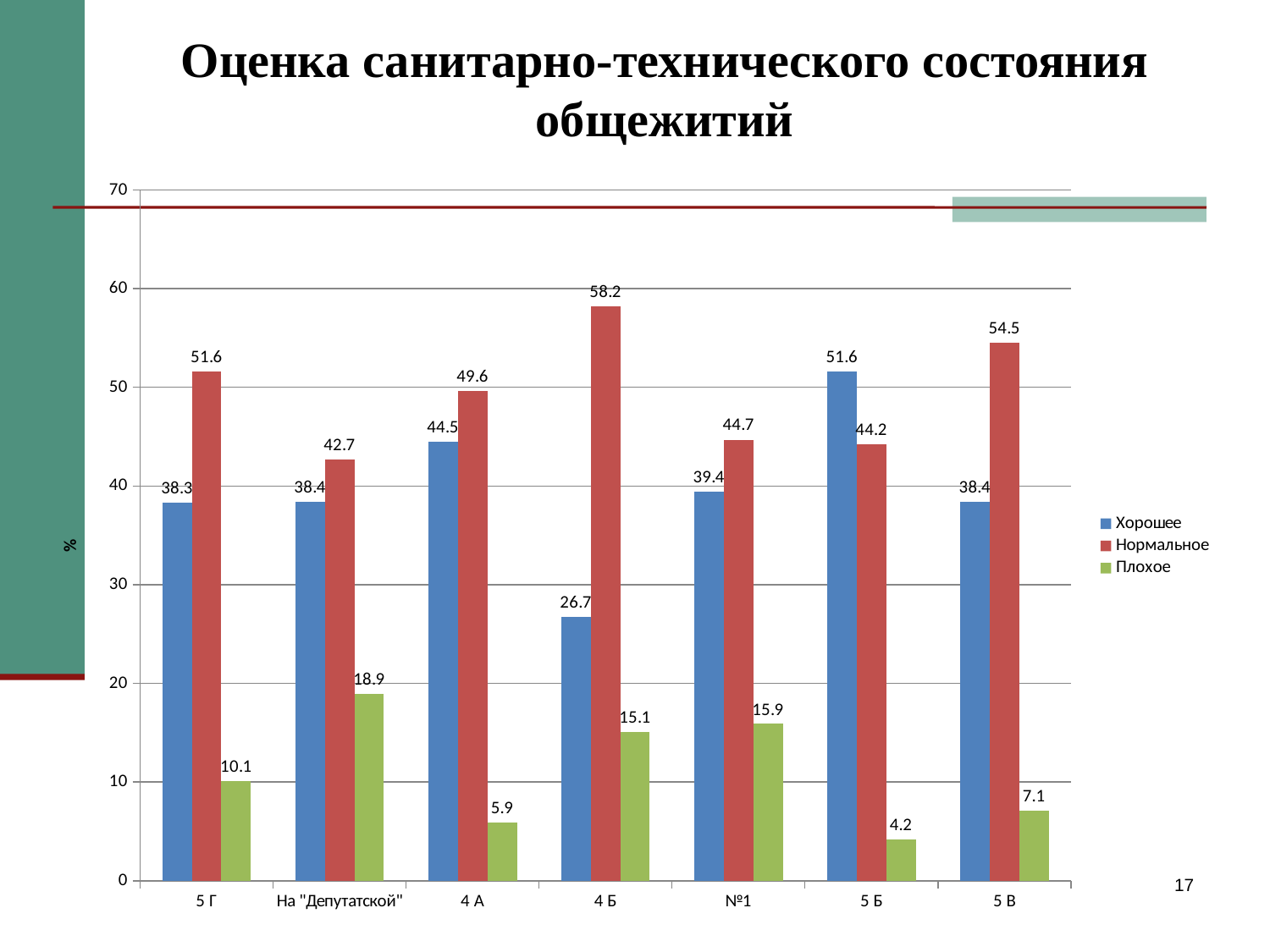
Which is larger for 5 Б: Хорошее or Нормальное? Хорошее Which category has the lowest Хорошее value? 4 Б What is the value of Плохое for На "Депутатской"? 18.9 What is the value of Нормальное for 4 Б? 58.2 What kind of chart is shown on the slide? Bar chart Which category has the lowest Плохое value? 5 Б How many categories are shown on the x axis? 7 How many series does the legend list? 3 What is the value of Хорошее for 5 Б? 51.6 What is the difference between the Нормальное and Хорошее values for 4 Б? 31.5 Which category has the highest Нормальное value? 4 Б What is the label of the y axis? %